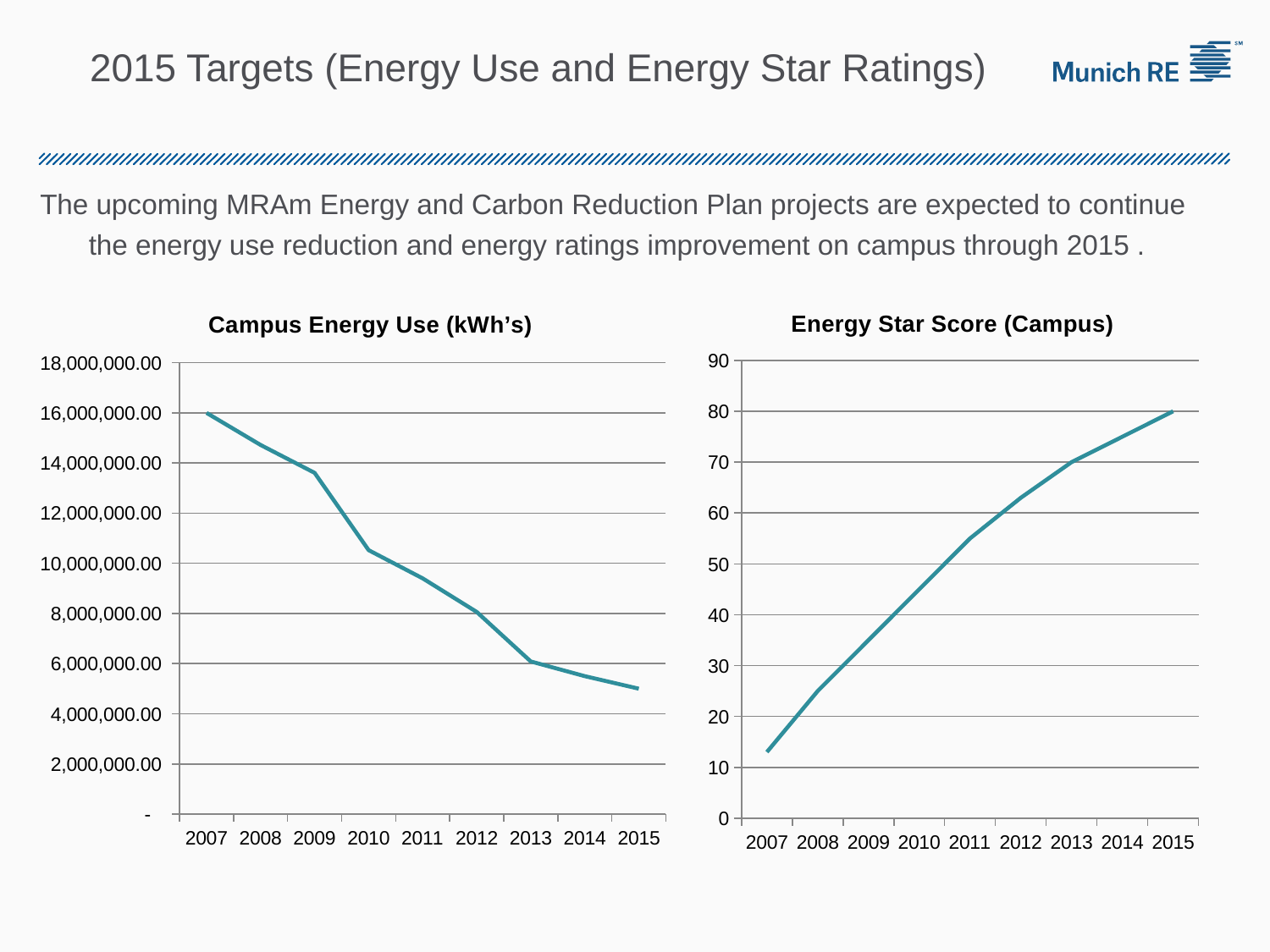
In the Energy Star Score (Campus) chart, is the score for 2009 larger or smaller than the score for 2012? smaller In the Energy Star Score (Campus) chart, is the value for 2011 greater or less than 50? greater How many years are plotted on the x axis of the Energy Star Score (Campus) chart? 9 In the Energy Star Score (Campus) chart, which year has the lowest score? 2007 In the Campus Energy Use (kWh's) chart, do the values rise or fall from 2007 to 2015? fall In the Energy Star Score (Campus) chart, do the values rise or fall from 2007 to 2015? rise In the Campus Energy Use (kWh's) chart, which year has the lowest energy use? 2015 In the Campus Energy Use (kWh's) chart, which year has the highest energy use? 2007 What kind of chart is the Campus Energy Use (kWh's) chart? line chart How many years are plotted on the x axis of the Campus Energy Use (kWh's) chart? 9 In the Campus Energy Use (kWh's) chart, is the value for 2010 greater or less than 12,000,000.00? less In the Energy Star Score (Campus) chart, which year has the highest score? 2015